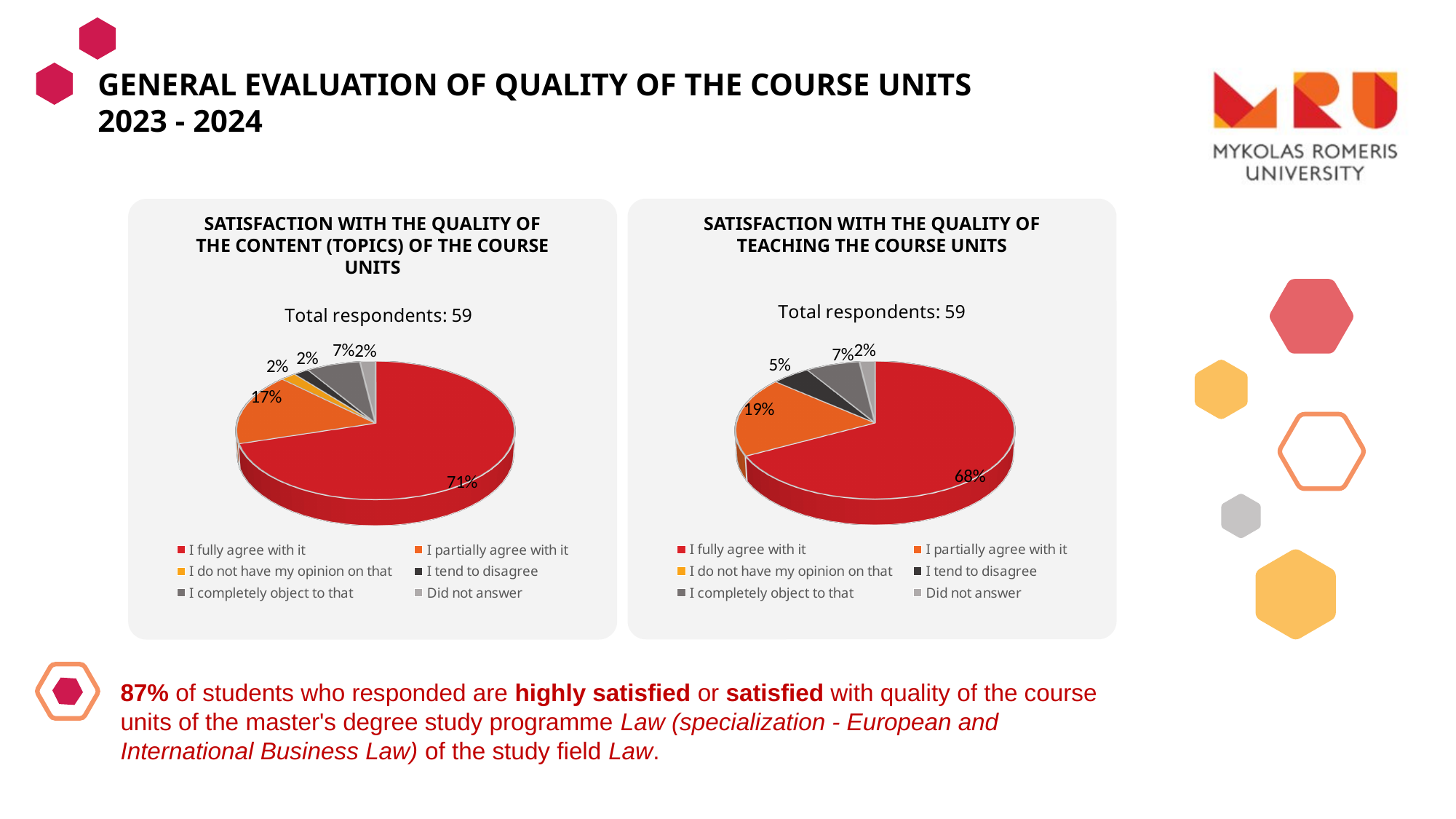
In the chart titled 'Satisfaction with the quality of teaching the course units', what share of respondents chose 'I fully agree with it'? 68% In the right chart (teaching the course units), what percentage chose 'I partially agree with it'? 19% In the right chart (teaching the course units), what percentage chose 'I tend to disagree'? 5% In the right chart (teaching the course units), what percentage is labelled for 'Did not answer'? 2% How many entries does the legend of the left chart (content of the course units) list? 6 In the left chart (content of the course units), which response category has the largest share? I fully agree with it What type of chart is used on this slide? Pie chart In the chart titled 'Satisfaction with the quality of the content (topics) of the course units', what share of respondents chose 'I fully agree with it'? 71% What is the difference between the 'I fully agree with it' shares in the left chart (content) and the right chart (teaching)? 3% How many total respondents are reported for the chart on teaching the course units? 59 Which chart has the larger 'I partially agree with it' share, the content chart or the teaching chart? The teaching chart In the left chart (content of the course units), what percentage chose 'I partially agree with it'? 17%